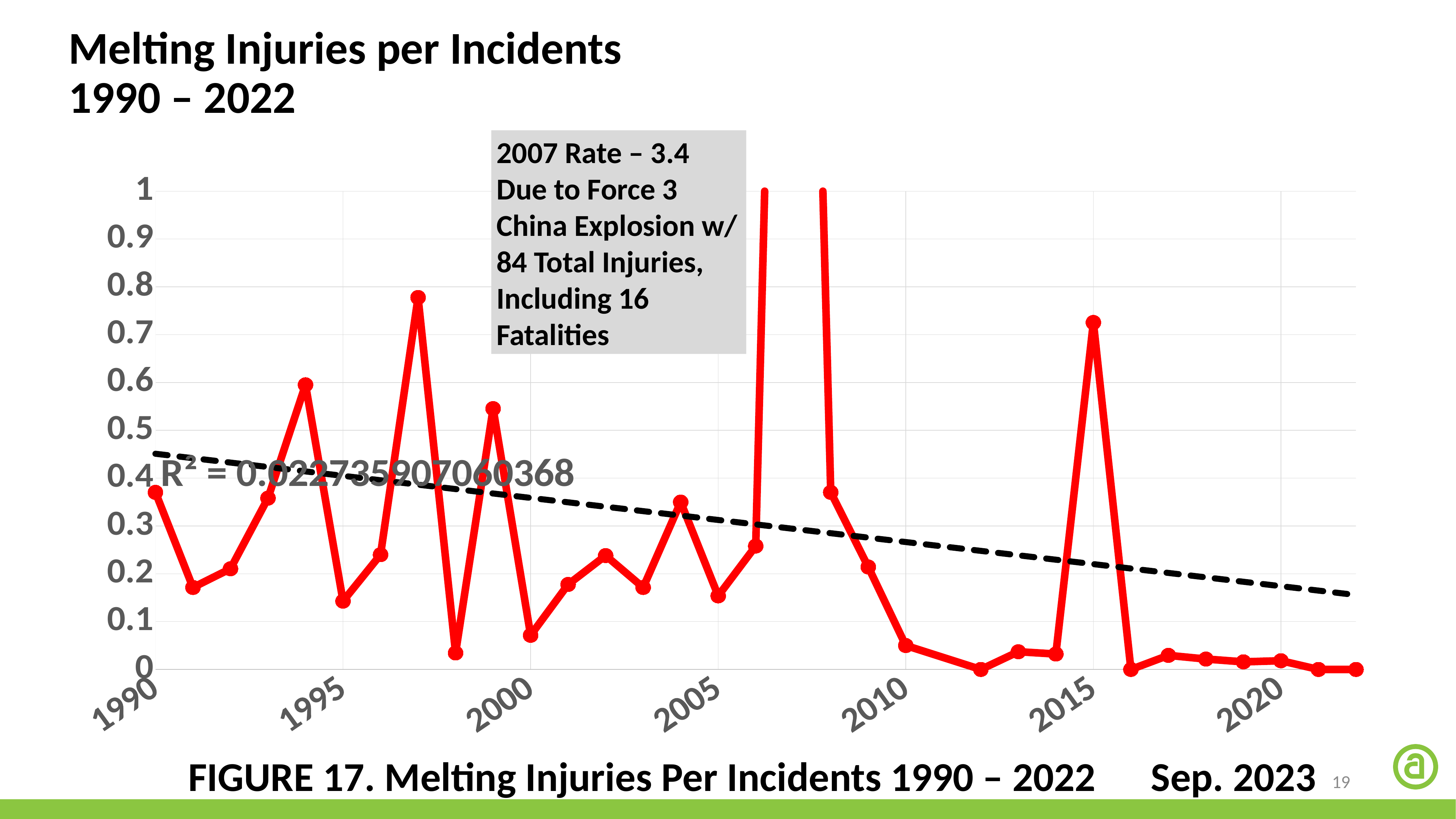
Is the value for 2020 greater or less than 0.1? less Which year has the larger value, 1990 or 2020? 1990 What kind of chart is shown on the slide? line chart Is the value for 2000 greater or less than 0.1? less Which year has the highest melting injuries per incidents rate? 2007 Does the dashed trendline rise or fall from 1990 to 2022? fall What was the melting injuries per incidents rate in 2007, according to the annotation? 3.4 Is the value for 1990 greater or less than 0.3? greater What R² value is printed on the chart? R² = 0.022735907060368 Which year has the larger value, 2010 or 2015? 2015